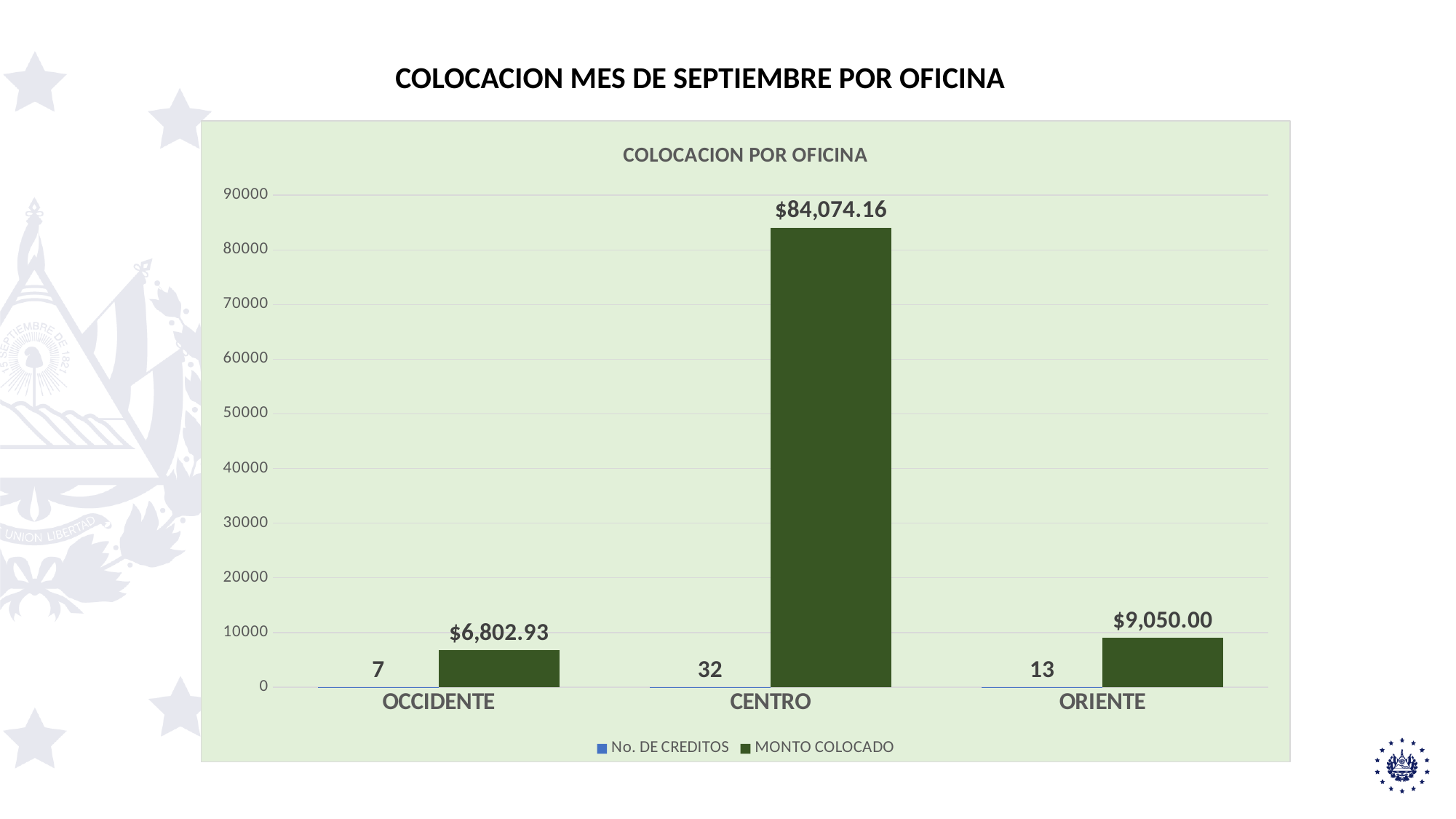
Which office has the highest MONTO COLOCADO? CENTRO What is the No. DE CREDITOS value for CENTRO? 32 What is the difference in No. DE CREDITOS between CENTRO and ORIENTE? 19 How many series does the legend list? 2 What is the MONTO COLOCADO value for CENTRO? $84,074.16 What kind of chart is shown on the slide? bar chart How many offices are shown on the x axis? 3 What is the No. DE CREDITOS value for ORIENTE? 13 Is the MONTO COLOCADO for CENTRO greater or less than 80000? greater Which has a larger MONTO COLOCADO, OCCIDENTE or ORIENTE? ORIENTE Which office has the lowest No. DE CREDITOS? OCCIDENTE What is the MONTO COLOCADO value for OCCIDENTE? $6,802.93